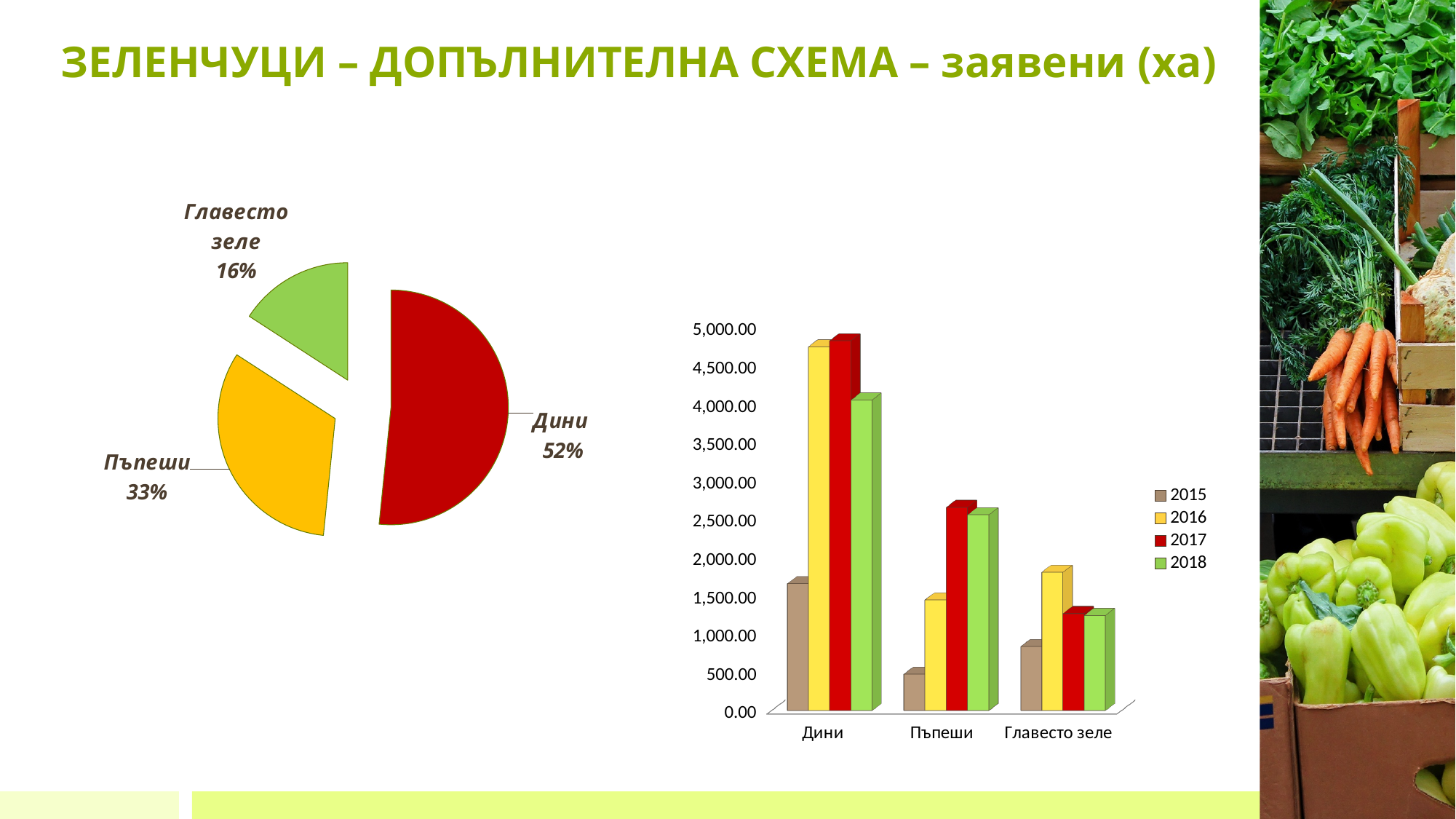
In the bar chart on the right, which category has the highest 2016 bar? Дини What kind of chart is the chart on the right? Bar chart In the pie chart on the left, which category has the smallest slice? Главесто зеле In the pie chart on the left, what share does Дини have? 52% In the bar chart on the right, is the 2015 value for Дини greater or less than 2,000.00? less In the bar chart on the right, which year has the lowest bar for Дини? 2015 How many series does the legend of the bar chart on the right list? 4 In the bar chart on the right, is the 2016 value for Дини greater or less than 4,500.00? greater How many slices does the pie chart on the left have? 3 In the bar chart on the right, is the 2015 value for Пъпеши greater or less than 1,000.00? less In the pie chart on the left, what is the difference in percentage points between the Дини and Главесто зеле slices? 36 percentage points In the pie chart on the left, what share does Пъпеши have? 33%